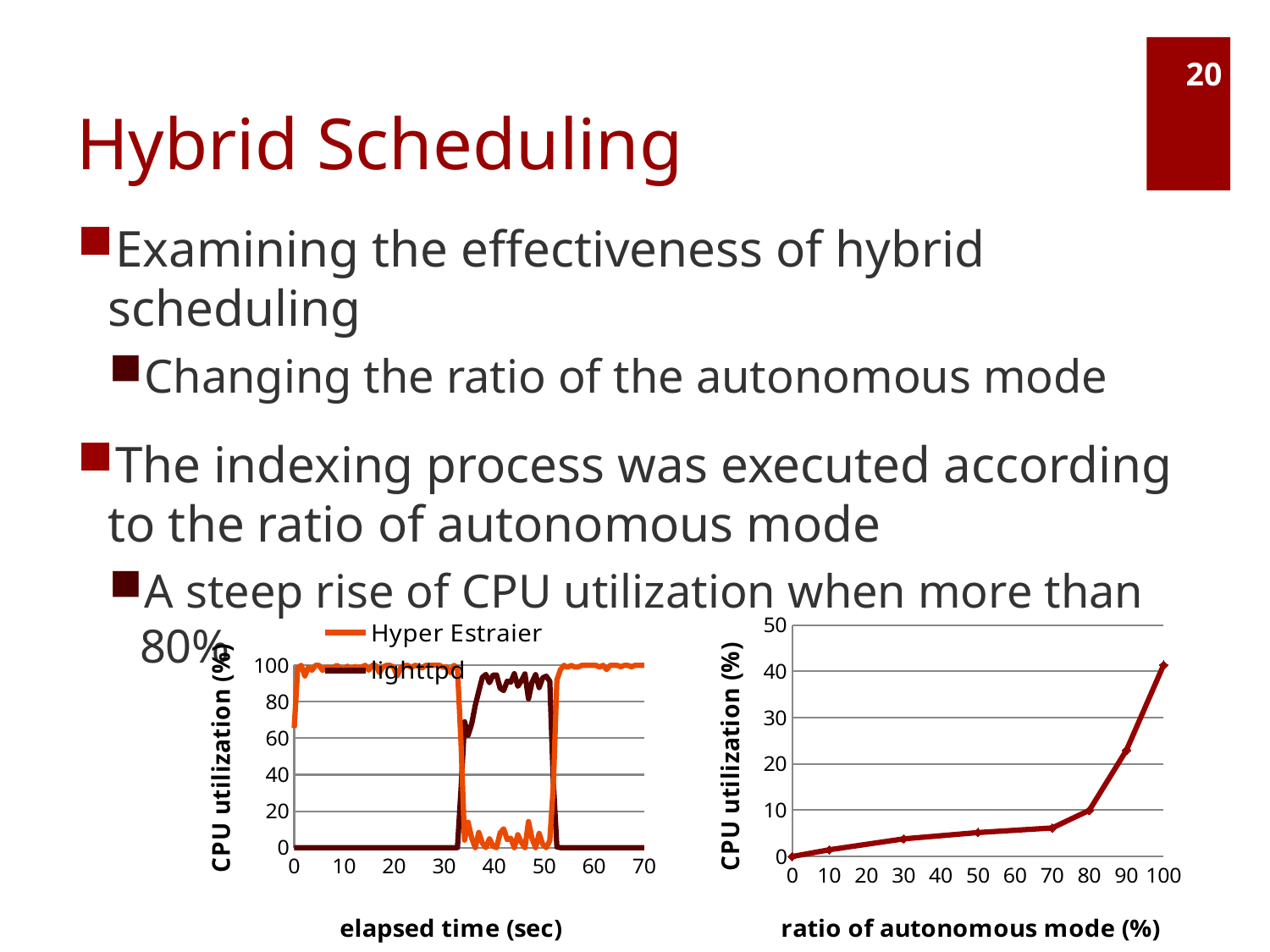
What kind of chart is the right-hand chart (CPU utilization vs ratio of autonomous mode)? line chart In the right-hand chart, is the CPU utilization at a ratio of autonomous mode of 100% greater or less than 30? greater In the left-hand chart, is the CPU utilization of lighttpd at an elapsed time of 40 sec greater or less than 60? greater What are the two series named in the legend of the left-hand chart? Hyper Estraier and lighttpd In the right-hand chart, is the CPU utilization at a ratio of autonomous mode of 90% greater or less than 20? greater In the right-hand chart, does CPU utilization rise or fall as the ratio of autonomous mode increases from 0 to 100? rise What is the x-axis title of the right-hand chart? ratio of autonomous mode (%) What kind of chart is the left-hand chart (CPU utilization vs elapsed time)? line chart How many series does the legend of the left-hand chart list? 2